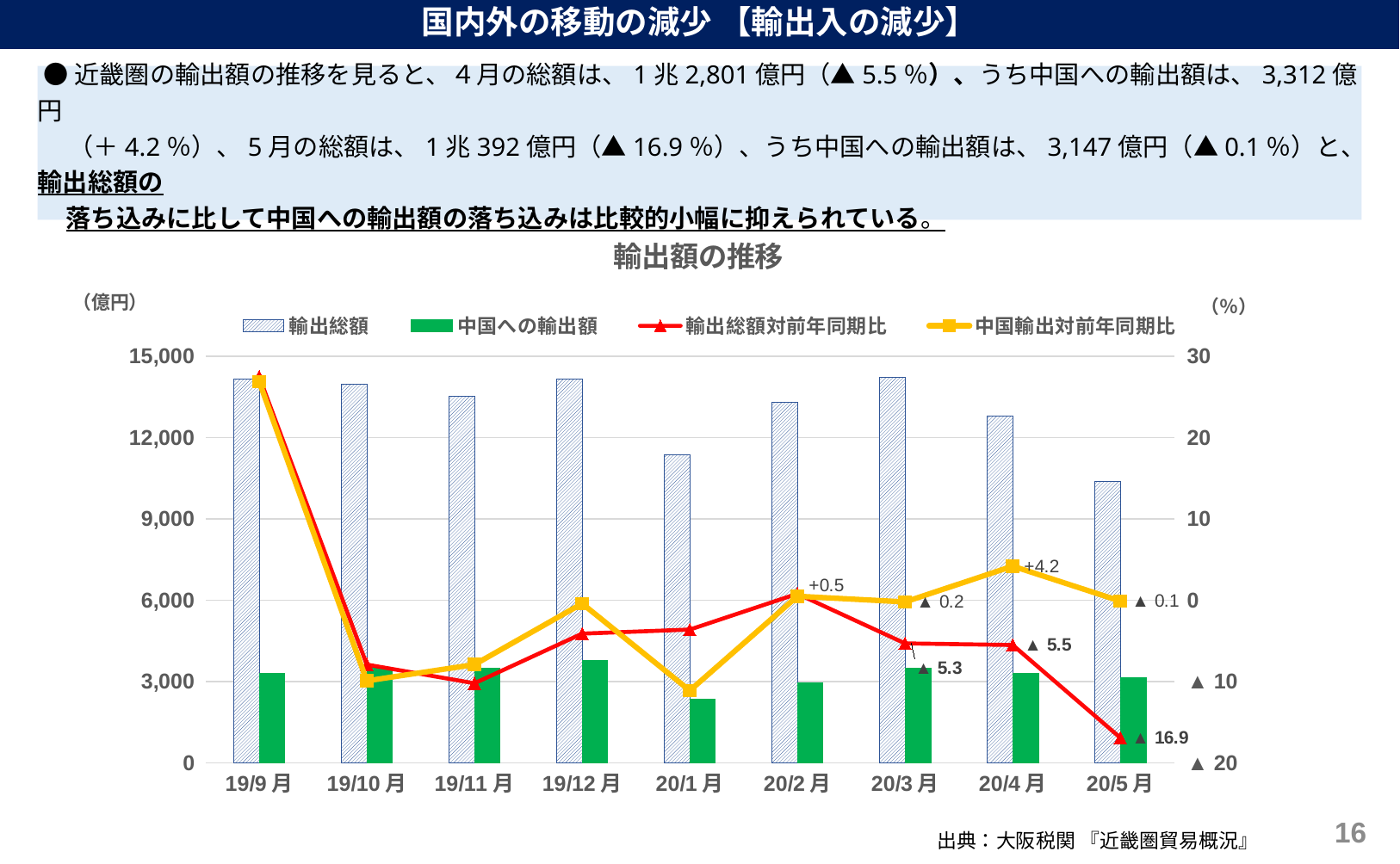
How many series does the legend of the 輸出額の推移 chart list? 4 What is the value of 輸出総額対前年同期比 for 20/4月? ▲5.5 What is the value of 中国輸出対前年同期比 for 20/4月? +4.2 Is the 中国への輸出額 bar for 20/1月 greater or less than 3,000? less What is the value of 輸出総額対前年同期比 for 20/3月? ▲5.3 What is the value of 輸出総額対前年同期比 for 20/5月? ▲16.9 How many months are shown on the x axis of the chart? 9 What is the value of 中国輸出対前年同期比 for 20/5月? ▲0.1 Does the 輸出総額対前年同期比 line rise or fall from 20/2月 to 20/5月? It falls In which month is the 輸出総額 bar the lowest? 20/5月 Is the 輸出総額 bar for 20/5月 greater or less than 12,000? less What kind of chart is shown on the slide? A combination bar and line chart